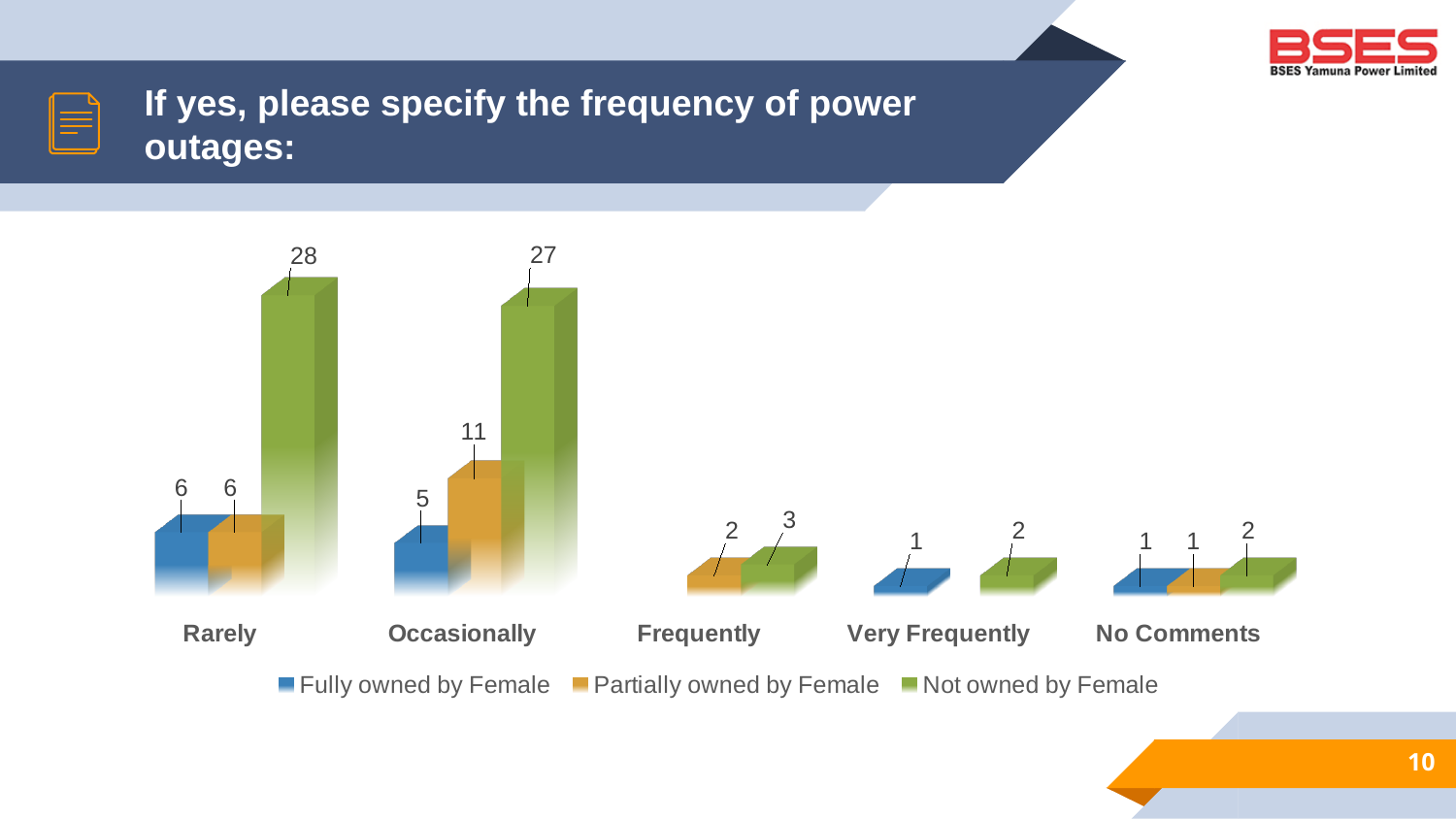
How many categories are shown on the x axis? 5 Which category has the highest value for Not owned by Female? Rarely What kind of chart is shown on the slide? Bar chart Which category has the lowest value for Fully owned by Female among those with a labelled bar? Very Frequently and No Comments (both 1) What is the value for Not owned by Female in the Frequently category? 3 What is the difference between the Not owned by Female values for Rarely and Occasionally? 1 What is the value for Partially owned by Female in the Occasionally category? 11 What is the value for Not owned by Female in the Rarely category? 28 How many series does the legend list? 3 What is the value for Fully owned by Female in the Occasionally category? 5 Which series is shown in green in the legend? Not owned by Female Which is larger in the Occasionally category: Partially owned by Female or Fully owned by Female? Partially owned by Female